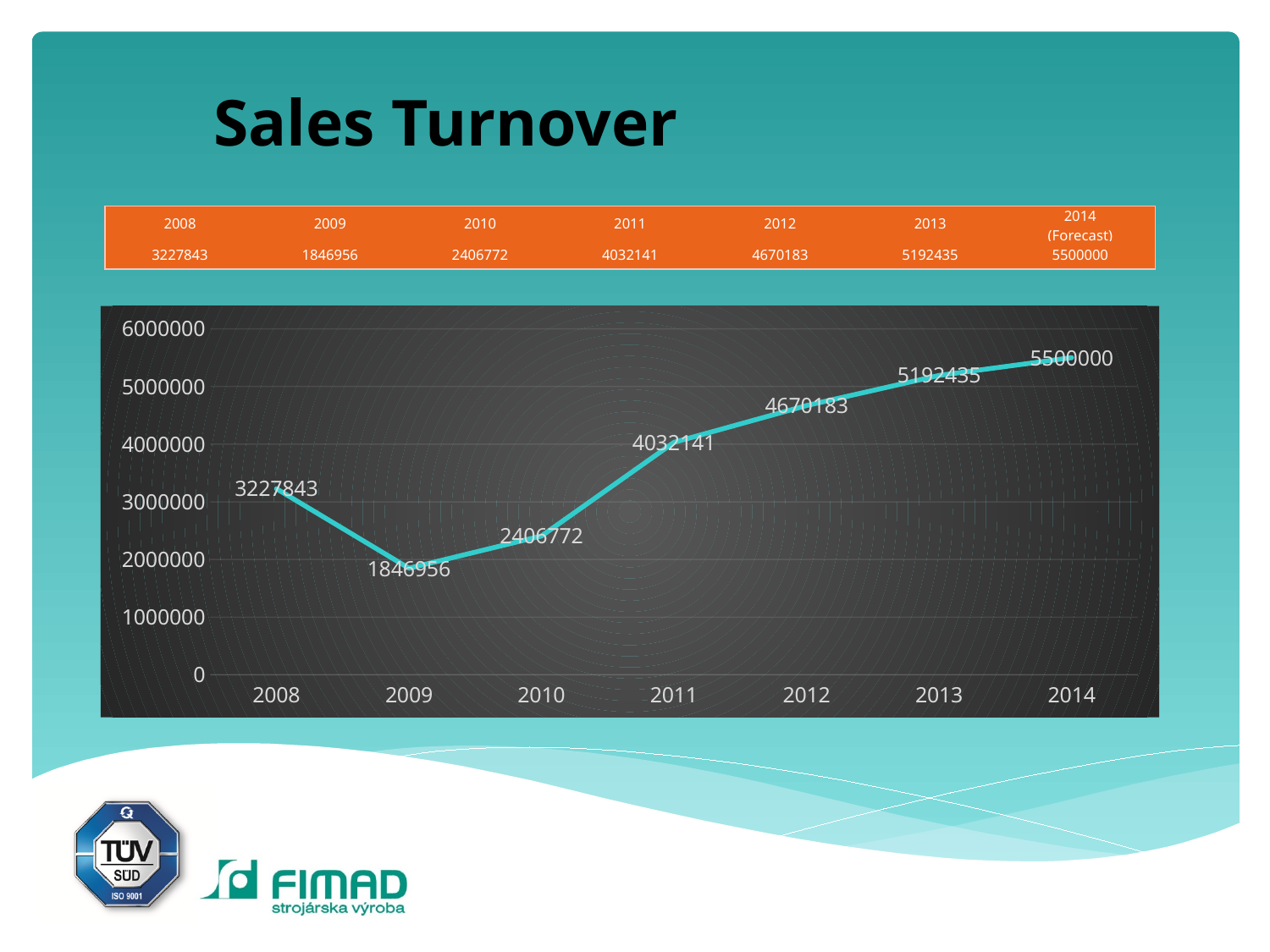
Is the sales turnover for 2012 greater or less than 4000000? greater What is the sales turnover value for 2009? 1846956 What is the forecast sales turnover value for 2014? 5500000 By how much did sales turnover fall from 2008 to 2009? 1380887 Does the sales turnover rise or fall from 2009 to 2014? rise Which year has a higher sales turnover, 2008 or 2010? 2008 What is the sales turnover value for 2011? 4032141 What is the difference in sales turnover between 2013 and 2012? 522252 Which year has the lowest sales turnover? 2009 How many years are plotted on the chart? 7 Which year has the highest sales turnover? 2014 What kind of chart is shown on the slide? line chart